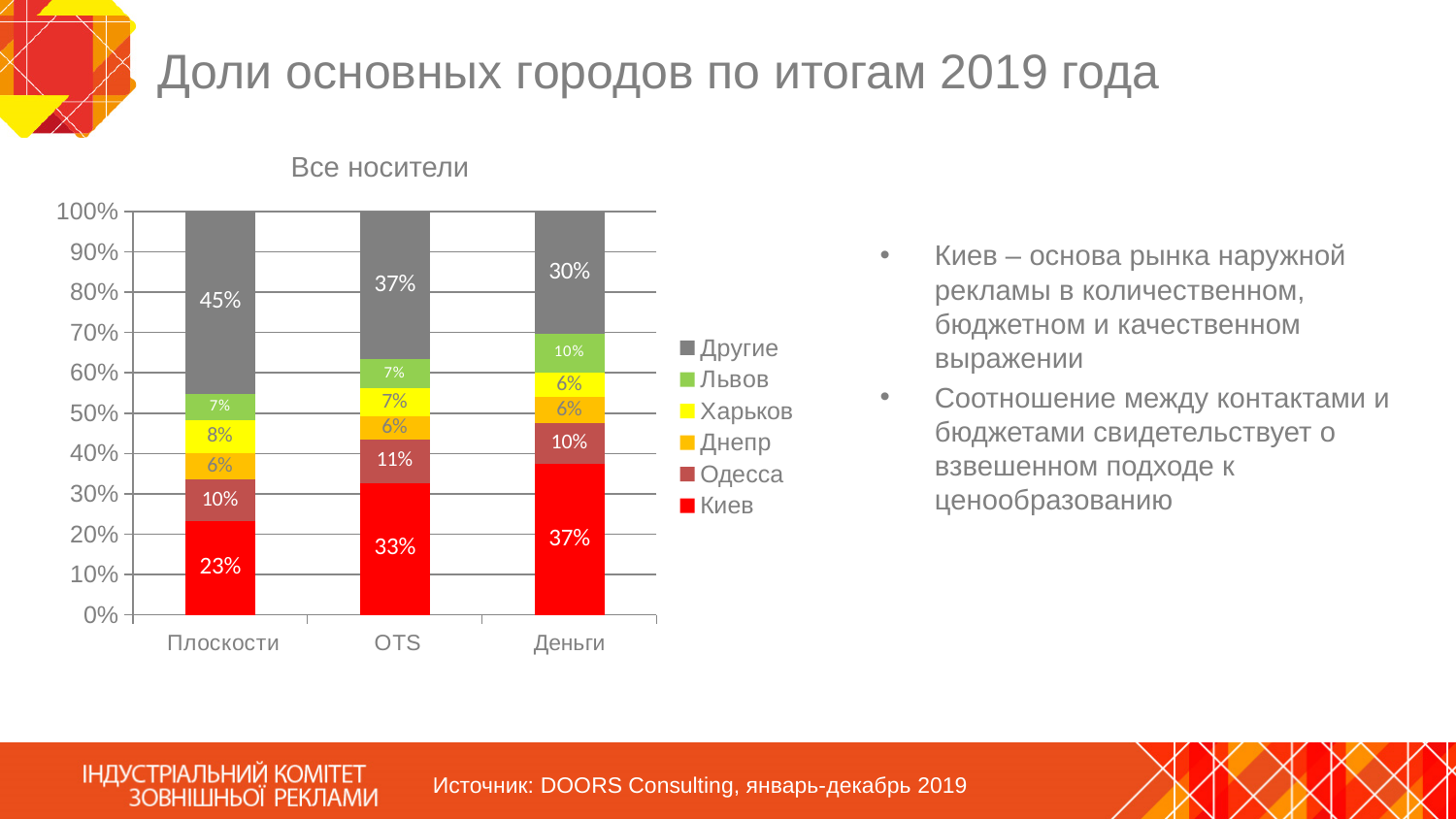
What kind of chart is shown on the slide? Stacked bar chart What is the value for Киев in the Плоскости bar? 23% What is the difference between the Киев share in Деньги and the Киев share in Плоскости? 14% What is the value for Одесса in the OTS bar? 11% What is the value for Другие in the OTS bar? 37% What is the value for Львов in the Деньги bar? 10% In which category does Киев have its highest share? Деньги Does the Киев share rise or fall from Плоскости to Деньги? Rise How many series does the legend list? 6 How many categories are shown on the x axis? 3 Which is larger in the Плоскости bar: Харьков or Днепр? Харьков In which category does Другие have its lowest share? Деньги